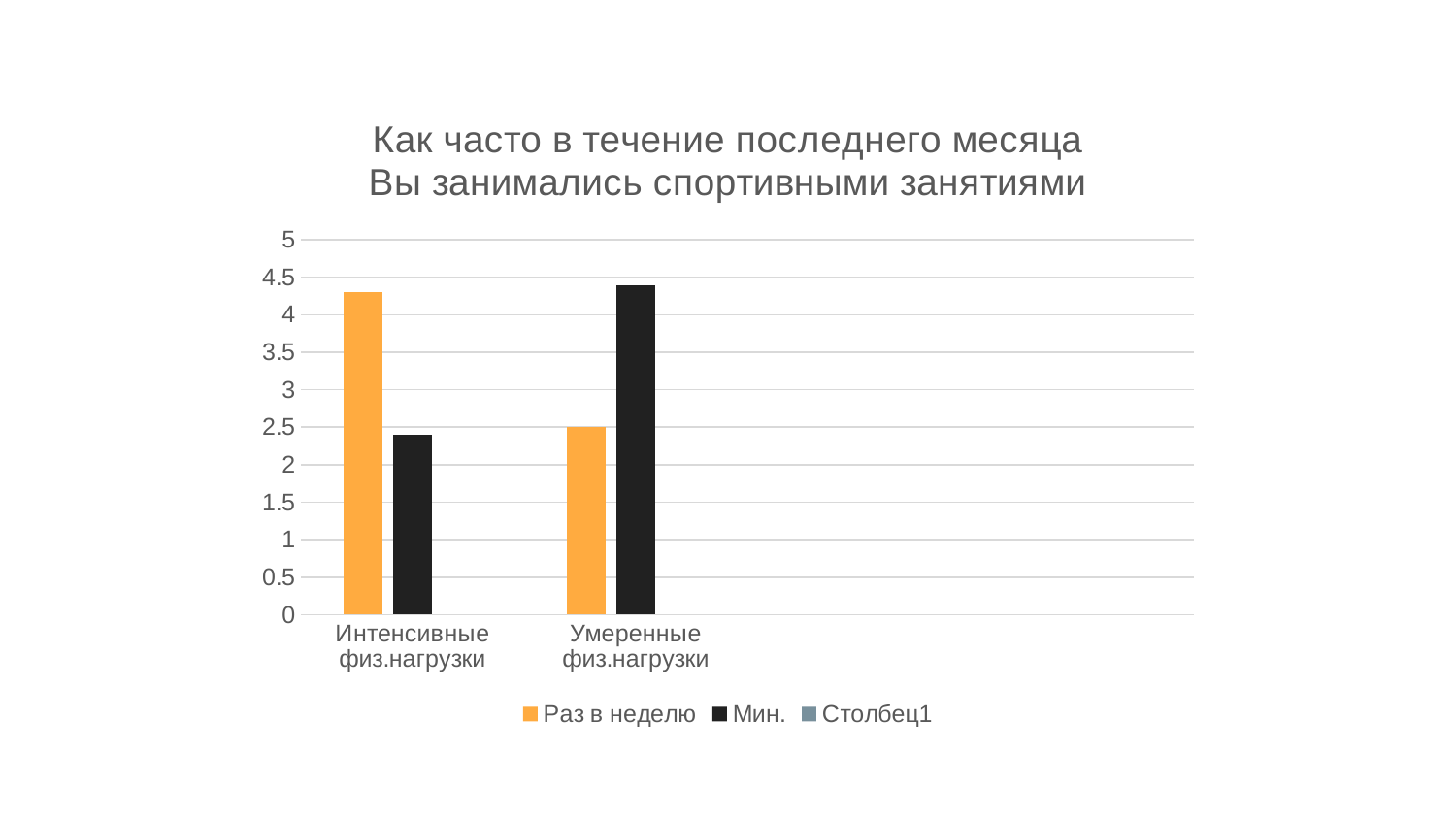
What kind of chart is shown on the slide? bar chart How many series does the legend of the chart list? 3 Is the value of 'Раз в неделю' for 'Интенсивные физ.нагрузки' greater or less than 4? greater Which category has the highest value for the 'Мин.' series? Умеренные физ.нагрузки For 'Умеренные физ.нагрузки', which series has the larger value, 'Раз в неделю' or 'Мин.'? Мин. Is the value of 'Мин.' for 'Интенсивные физ.нагрузки' greater or less than 3? less Is the value of 'Раз в неделю' for 'Умеренные физ.нагрузки' greater or less than 3? less Which category has the lowest value for the 'Раз в неделю' series? Умеренные физ.нагрузки For 'Интенсивные физ.нагрузки', which series has the larger value, 'Раз в неделю' or 'Мин.'? Раз в неделю What colour are the bars of the 'Мин.' series? black How many categories are shown on the x axis of the chart? 2